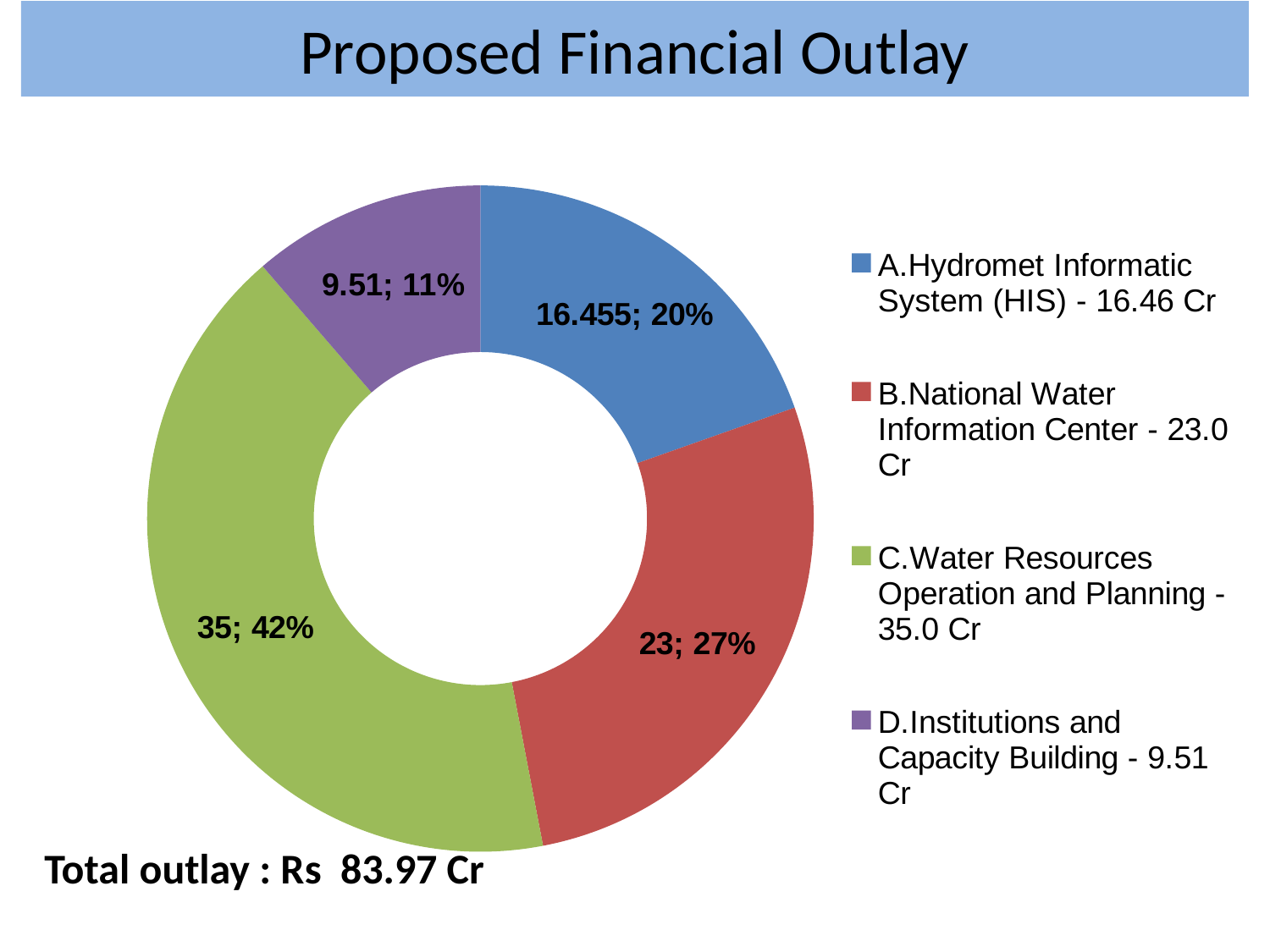
What percentage share does C.Water Resources Operation and Planning have? 42% Which category has the largest slice? C.Water Resources Operation and Planning Which category has the smallest slice? D.Institutions and Capacity Building What is the value shown for A.Hydromet Informatic System (HIS)? 16.455 What percentage share does A.Hydromet Informatic System (HIS) have? 20% What is the value shown for D.Institutions and Capacity Building? 9.51 What is the difference between the values for C.Water Resources Operation and Planning and B.National Water Information Center? 12 How many categories does the chart show? 4 What kind of chart is shown on the slide? Pie chart (doughnut) What is the total outlay stated on the slide? Rs 83.97 Cr Which is larger, the slice for B.National Water Information Center or the slice for A.Hydromet Informatic System (HIS)? B.National Water Information Center What is the value shown for B.National Water Information Center? 23